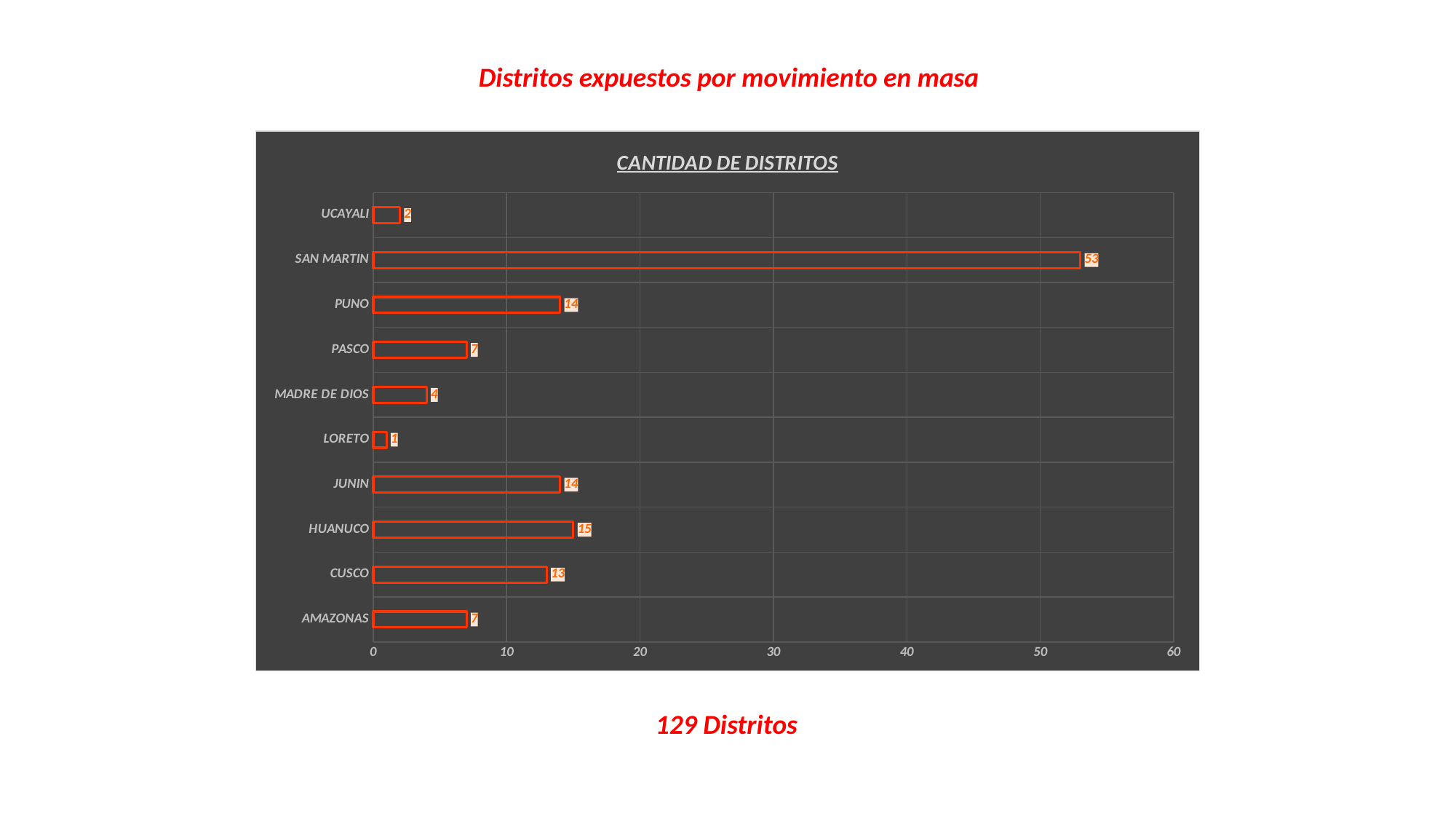
Which category has the highest value? SAN MARTIN What is the value for SAN MARTIN? 53 Is the value for SAN MARTIN greater or less than 50? greater What kind of chart is shown? bar chart Which category has the lowest value? LORETO What is the value for HUANUCO? 15 What is the title of the chart? CANTIDAD DE DISTRITOS What is the value for MADRE DE DIOS? 4 What is the difference between the values for PASCO and LORETO? 6 How many categories are shown on the chart? 10 Which is larger, the value for CUSCO or the value for PUNO? PUNO What is the difference between the values for SAN MARTIN and HUANUCO? 38